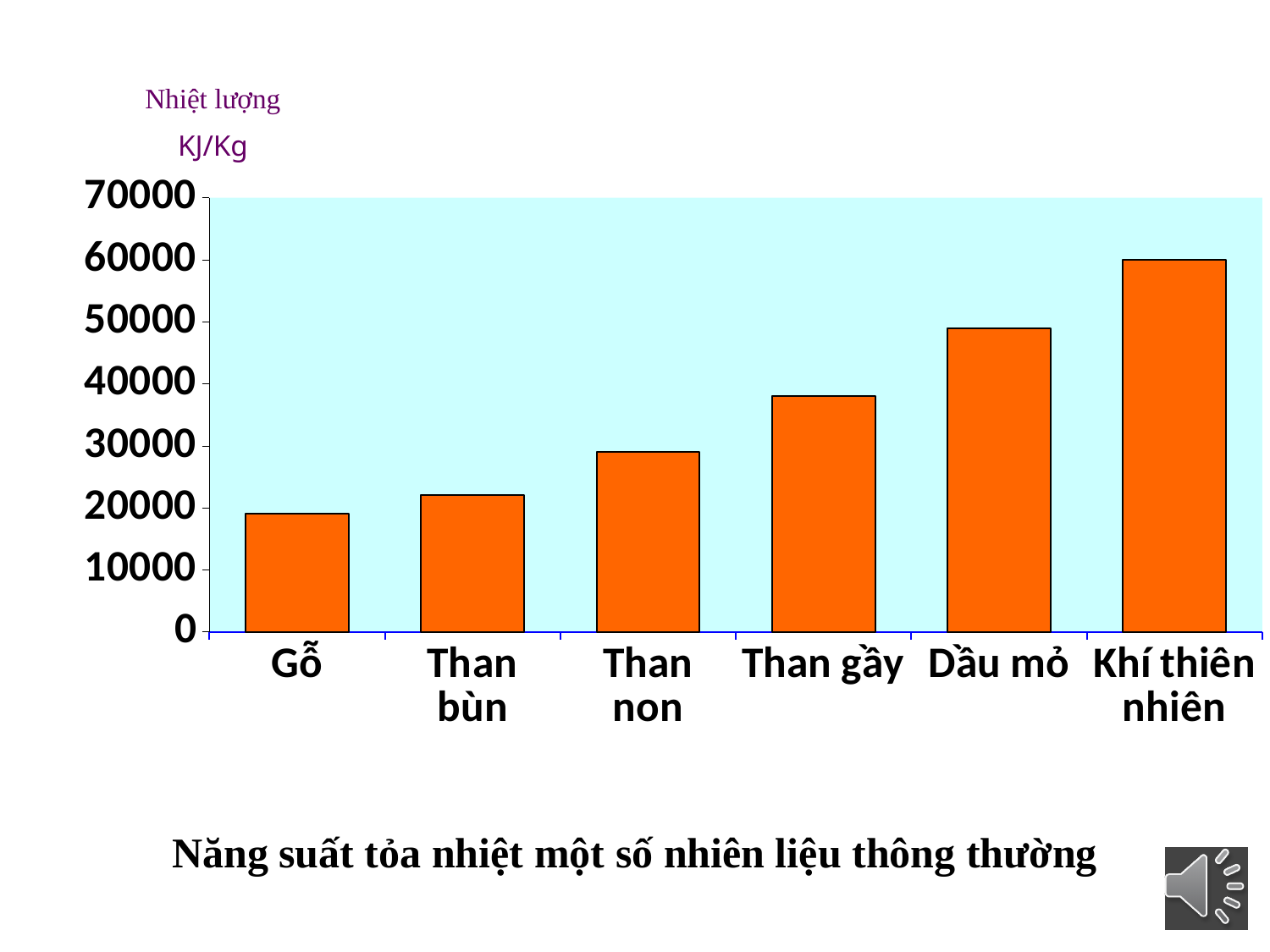
Is the value for Than gầy greater or less than 30000? greater Which fuel has the lowest value on the chart? Gỗ What is the title written below the chart? Năng suất tỏa nhiệt một số nhiên liệu thông thường What unit is shown for the vertical axis? KJ/Kg How many fuel categories are plotted on the chart? 6 Which fuel has the highest value on the chart? Khí thiên nhiên Which is larger, the value for Dầu mỏ or the value for Than gầy? Dầu mỏ Is the value for Dầu mỏ greater or less than 40000? greater What kind of chart is shown on the slide? bar chart Is the value for Than bùn greater or less than 20000? greater Do the values rise or fall moving from left to right along the x axis? rise